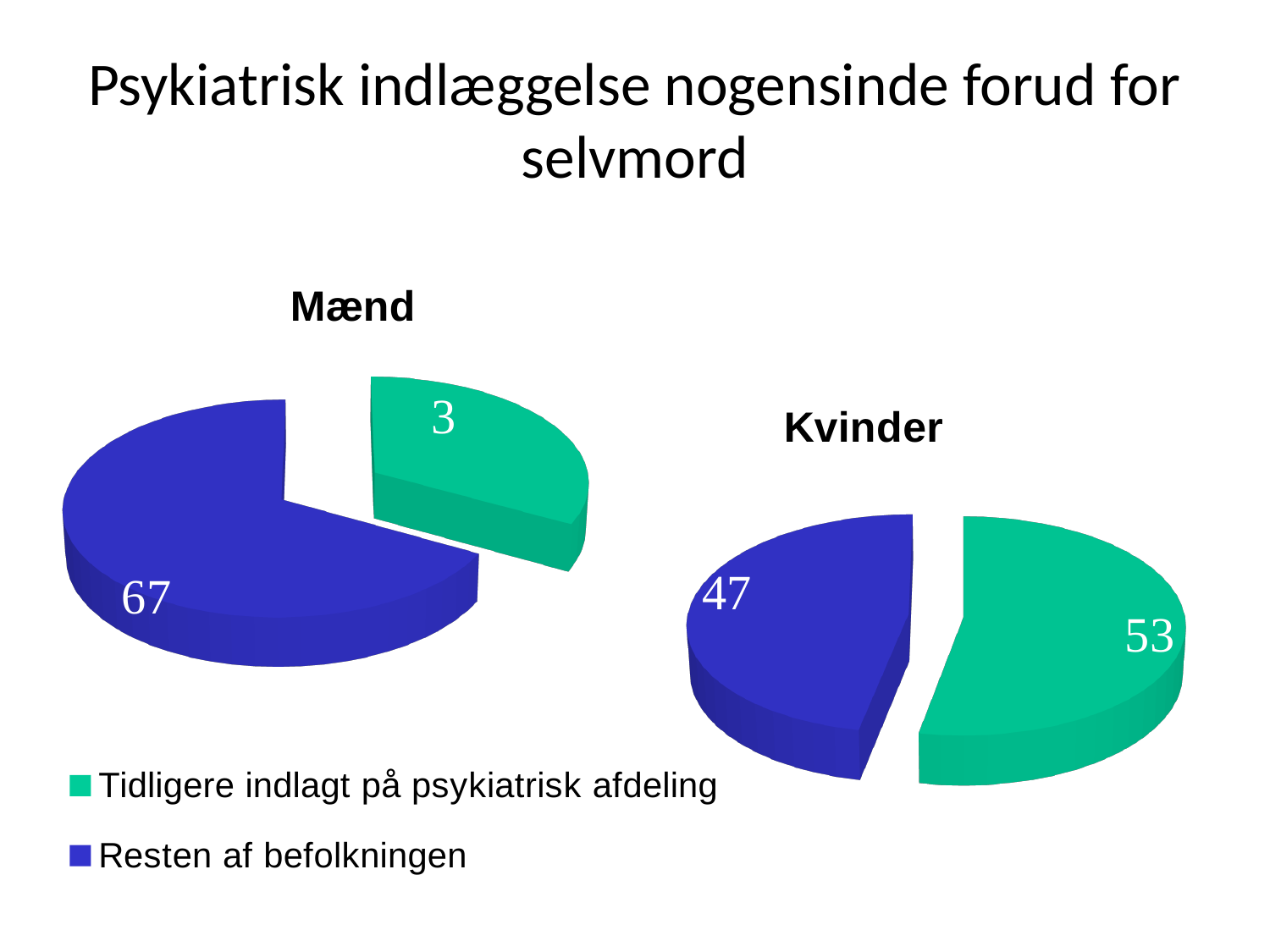
How many slices does the Mænd pie chart have? 2 In the Mænd pie chart, what value is shown for Resten af befolkningen? 67 In the Kvinder pie chart, which category has the smallest slice? Resten af befolkningen Which colour represents Resten af befolkningen in the legend? Blue In the Mænd pie chart, which category has the largest slice? Resten af befolkningen In the Kvinder pie chart, what share of the pie does Tidligere indlagt på psykiatrisk afdeling represent? 53% In the Kvinder pie chart, what is the difference between the two slice values? 6 What type of chart is used for Kvinder? Pie chart In the Mænd pie chart, what value is shown for Tidligere indlagt på psykiatrisk afdeling? 33 In the Kvinder pie chart, what value is shown for Tidligere indlagt på psykiatrisk afdeling? 53 In the Kvinder pie chart, what value is shown for Resten af befolkningen? 47 In the Kvinder pie chart, which is larger: Tidligere indlagt på psykiatrisk afdeling or Resten af befolkningen? Tidligere indlagt på psykiatrisk afdeling